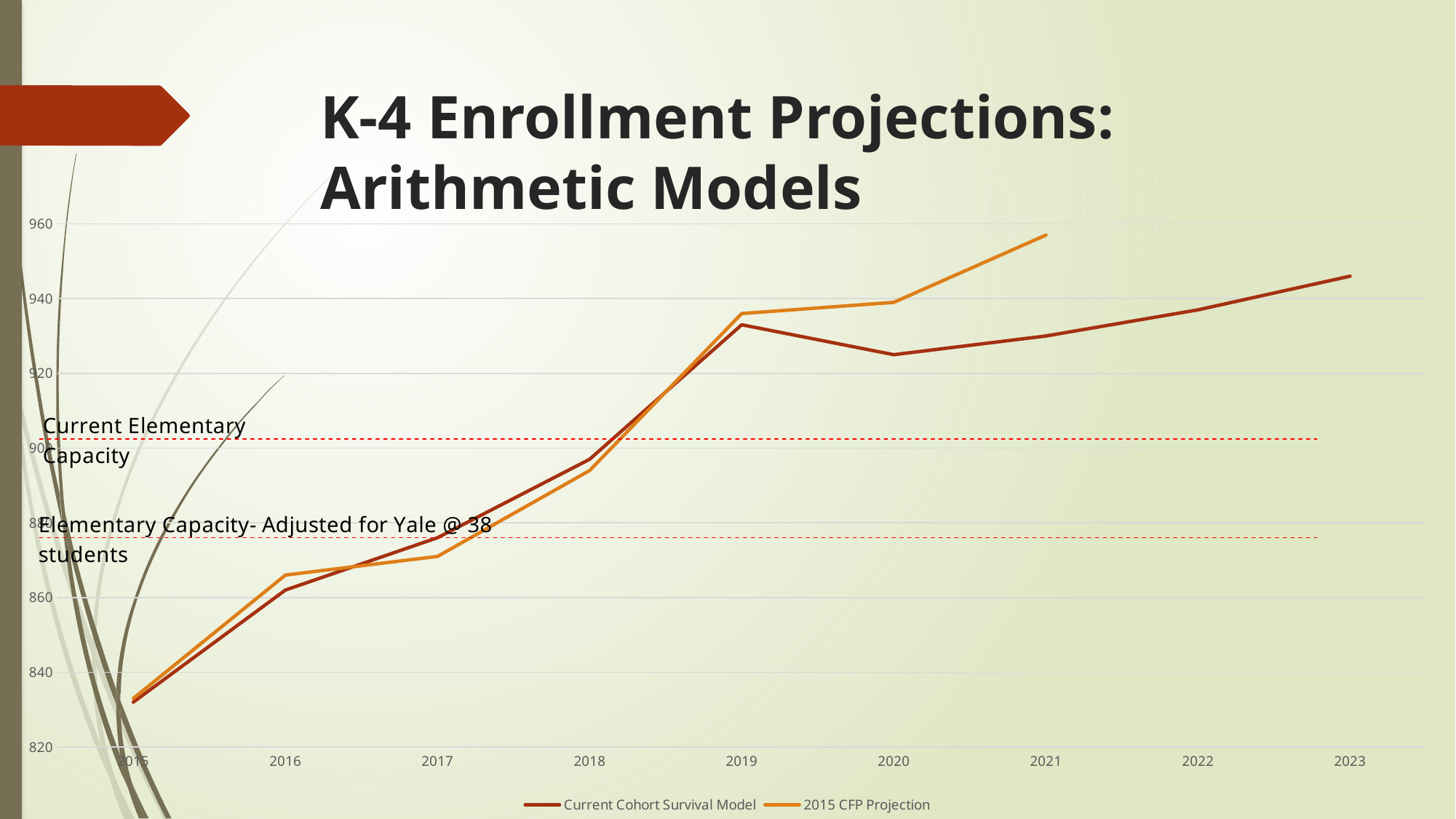
Which year has the lowest value for the Current Cohort Survival Model series? 2015 What kind of chart is shown on the slide? line chart Does the Current Cohort Survival Model series rise or fall from 2015 to 2019? rise How many series does the legend list? 2 Is the value for the Current Cohort Survival Model in 2019 greater or less than 920? greater Which year has the highest value for the 2015 CFP Projection series? 2021 Is the value for the Current Cohort Survival Model in 2015 greater or less than 840? less Which series stops at 2021 rather than continuing to 2023? 2015 CFP Projection In 2021, which series has the higher value, Current Cohort Survival Model or 2015 CFP Projection? 2015 CFP Projection Is the value for the 2015 CFP Projection in 2021 greater or less than 940? greater Which year has the highest value for the Current Cohort Survival Model series? 2023 How many years are shown on the x axis? 9